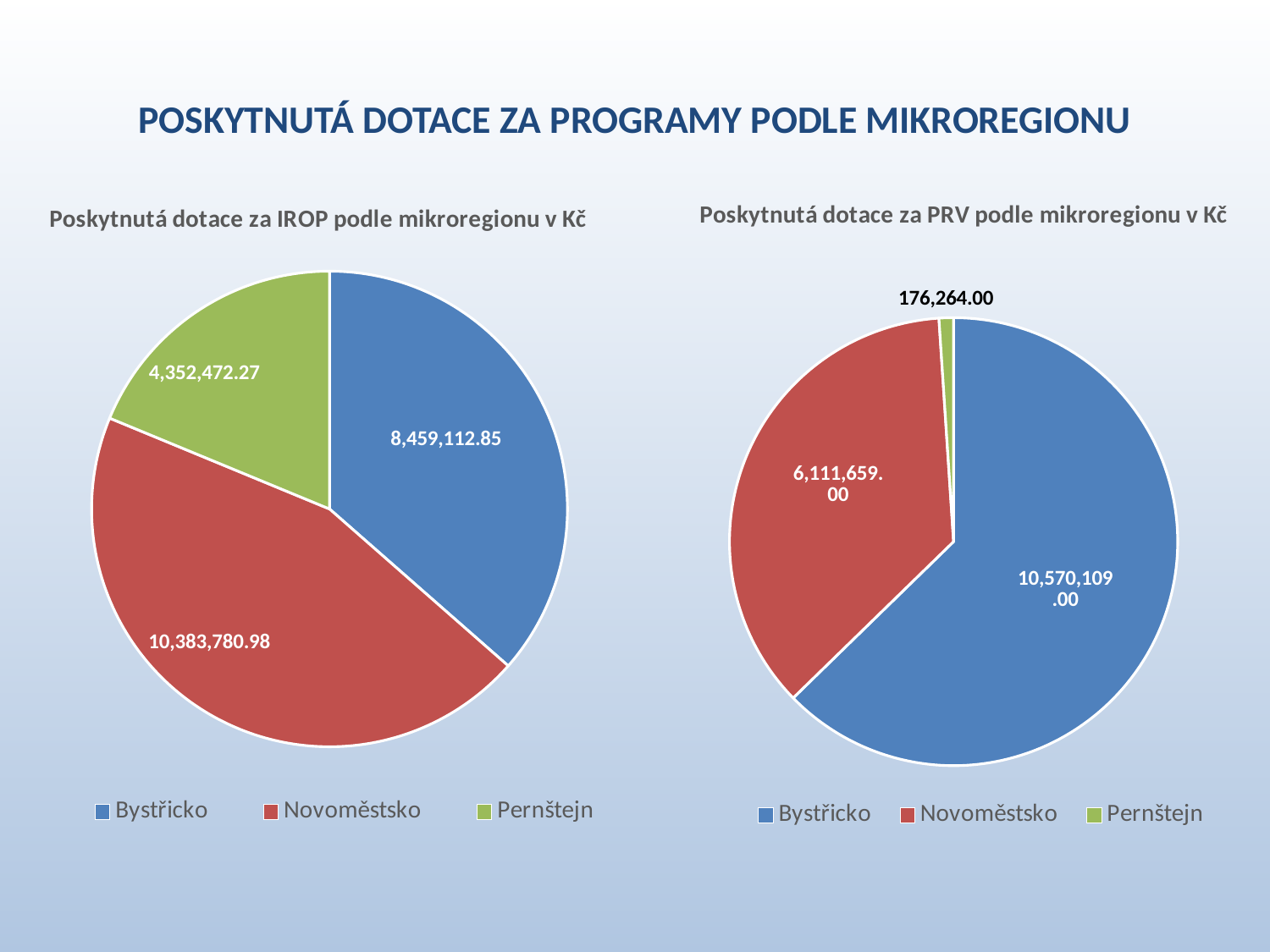
In the chart 'Poskytnutá dotace za PRV podle mikroregionu v Kč', what is the difference between the values for Bystřicko and Novoměstsko? 4,458,450.00 In the chart 'Poskytnutá dotace za IROP podle mikroregionu v Kč', which colour represents Pernštejn in the legend? Green How many slices does the chart 'Poskytnutá dotace za IROP podle mikroregionu v Kč' have? 3 In the chart 'Poskytnutá dotace za PRV podle mikroregionu v Kč', which microregion has the smallest slice? Pernštejn In the chart 'Poskytnutá dotace za PRV podle mikroregionu v Kč', what is the value for Pernštejn? 176,264.00 In the chart 'Poskytnutá dotace za IROP podle mikroregionu v Kč', what is the value for Pernštejn? 4,352,472.27 In the chart 'Poskytnutá dotace za IROP podle mikroregionu v Kč', which microregion has the largest slice? Novoměstsko In the chart 'Poskytnutá dotace za IROP podle mikroregionu v Kč', what is the difference between the values for Novoměstsko and Bystřicko? 1,924,668.13 In the chart 'Poskytnutá dotace za PRV podle mikroregionu v Kč', which is larger, the value for Bystřicko or for Novoměstsko? Bystřicko What type of chart is 'Poskytnutá dotace za PRV podle mikroregionu v Kč'? Pie chart In the chart 'Poskytnutá dotace za PRV podle mikroregionu v Kč', what is the value for Bystřicko? 10,570,109.00 In the chart 'Poskytnutá dotace za IROP podle mikroregionu v Kč', what is the value for Novoměstsko? 10,383,780.98